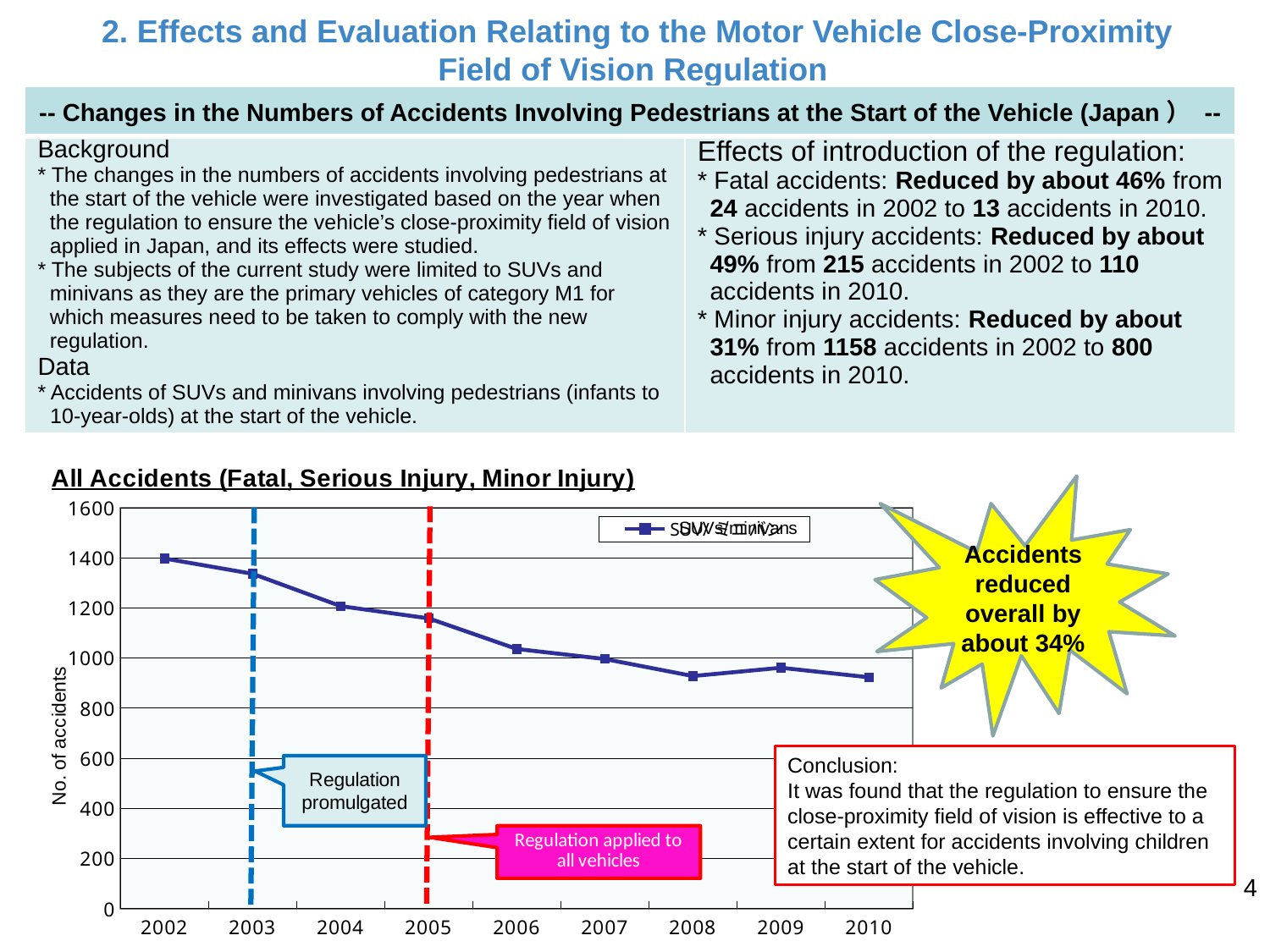
How many series does the legend of the chart list? 1 What is the label on the vertical axis of the chart? No. of accidents What is the title of the chart? All Accidents (Fatal, Serious Injury, Minor Injury) Is the value for 2002 greater or less than 1200? greater Do the values on the chart generally rise or fall from 2002 to 2010? fall Is the value for 2010 greater or less than 1000? less Is the value for 2008 greater or less than 1000? less Which year has the highest number of accidents on the chart? 2002 What kind of chart is shown on the slide? line chart How many data points are plotted on the line chart? 9 Which year has the larger value, 2002 or 2010? 2002